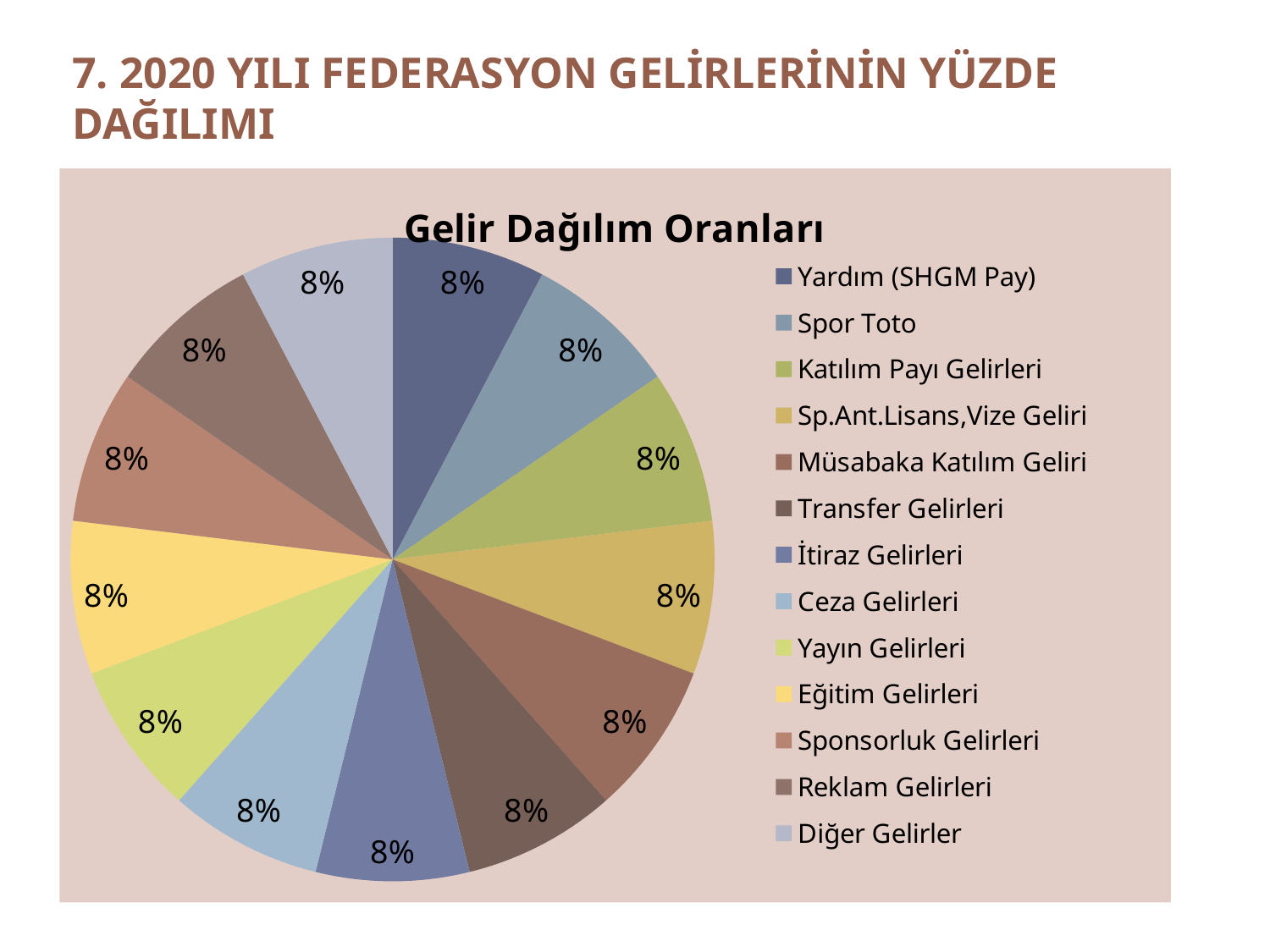
What is the difference between the values for Spor Toto and Reklam Gelirleri? 0% What is the value shown for Spor Toto? 8% What percentage is shown for Eğitim Gelirleri? 8% What percentage is shown for Transfer Gelirleri? 8% What is the value shown for Sponsorluk Gelirleri? 8% What kind of chart is shown on the slide? pie chart What is the title of the chart? Gelir Dağılım Oranları How many entries does the legend list? 13 What share of the pie does Yardım (SHGM Pay) represent? 8% What share of the pie does Diğer Gelirler represent? 8% How many slices does the pie chart have? 13 Which legend entry is listed first? Yardım (SHGM Pay)